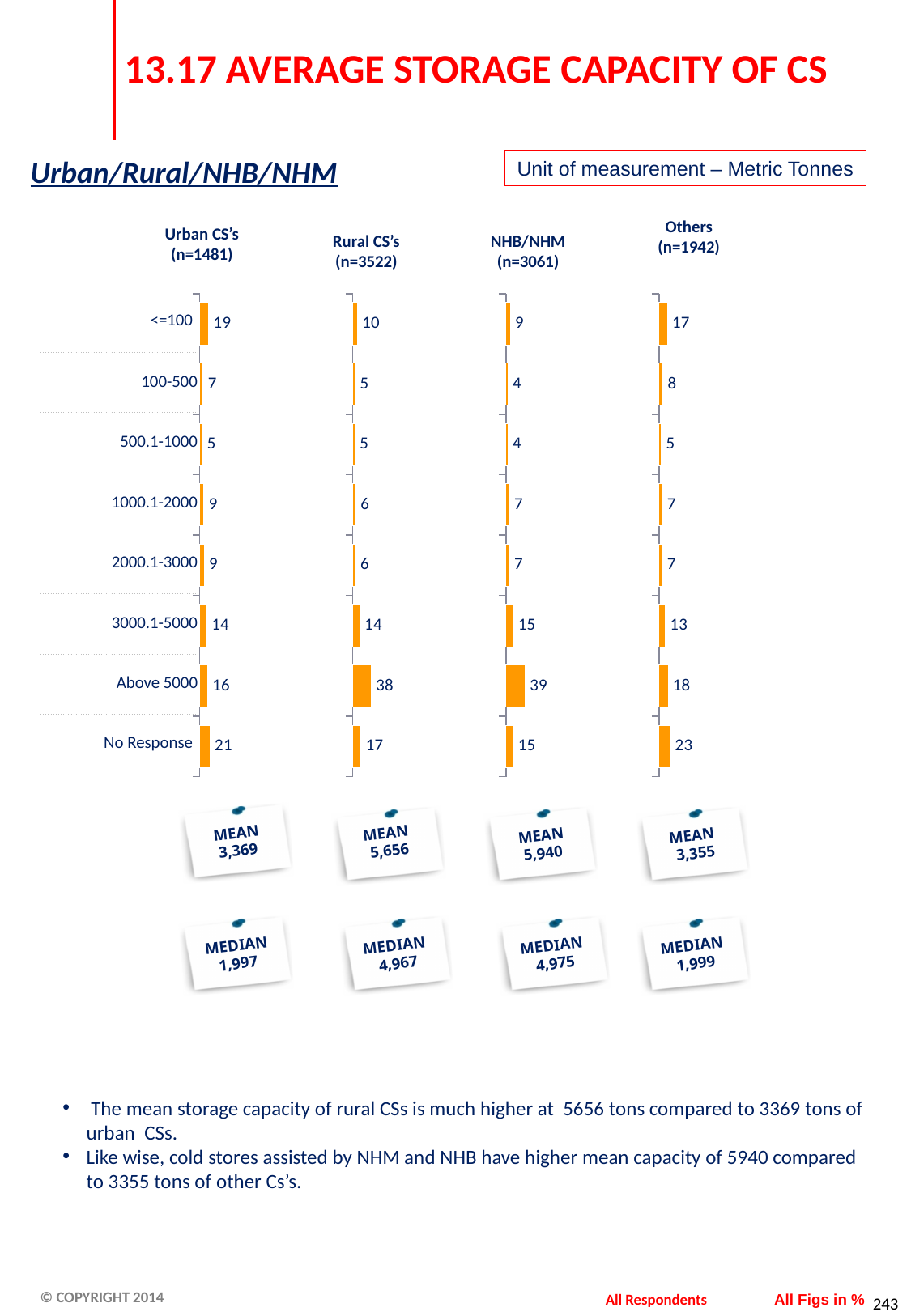
How many categories are shown in the Urban CS's chart? 8 What unit of measurement is stated on the slide for the storage capacity? Metric Tonnes In the NHB/NHM chart, what is the value for the '3000.1-5000' category? 15 In the Rural CS's chart, what is the value for 'No Response'? 17 In the NHB/NHM chart, what is the difference between the 'Above 5000' value and the 'No Response' value? 24 Which is larger: the 'Above 5000' value in the Rural CS's chart or the 'Above 5000' value in the Others chart? Rural CS's What is the sample size (n) shown for the Rural CS's chart? 3522 In the Urban CS's chart, which category has the lowest value? 500.1-1000 In the Rural CS's chart, which category has the highest value? Above 5000 What type of chart is used to show the storage capacity distribution for Urban CS's? Bar chart In the Others chart, what is the value for the '<=100' category? 17 In the Urban CS's chart, what is the value for the 'Above 5000' category? 16